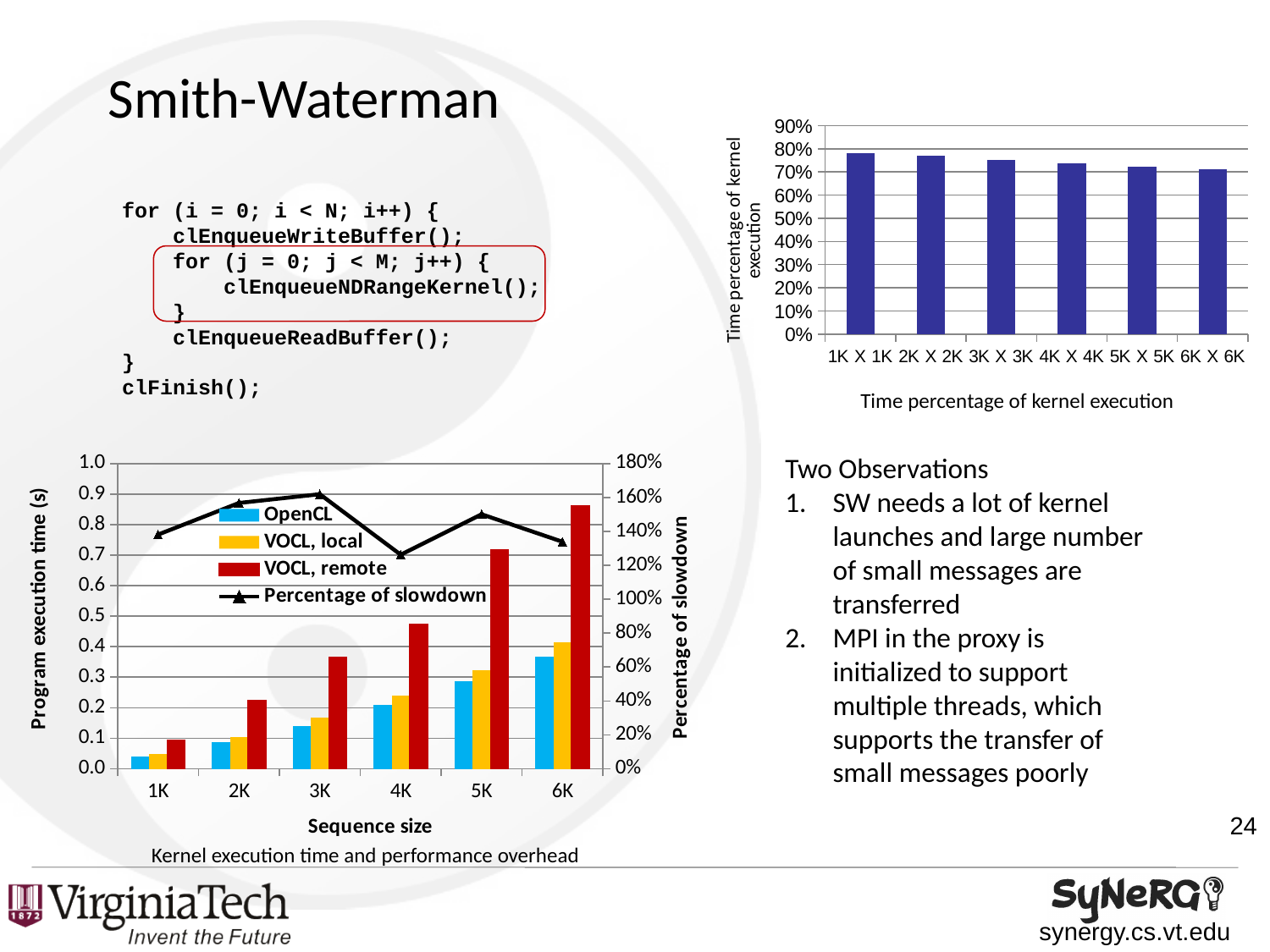
In the 'Kernel execution time and performance overhead' chart (bottom left), which series has the tallest bar at sequence size 6K? VOCL, remote In the 'Kernel execution time and performance overhead' chart (bottom left), what is the label of the left vertical axis? Program execution time (s) In the 'Time percentage of kernel execution' chart (top right), which category has the highest value? 1K X 1K In the 'Kernel execution time and performance overhead' chart (bottom left), do the OpenCL execution times rise or fall as sequence size increases? rise In the 'Kernel execution time and performance overhead' chart (bottom left), at which sequence size is the Percentage of slowdown lowest? 4K In the 'Kernel execution time and performance overhead' chart (bottom left), is the VOCL, remote execution time at 6K greater or less than 0.8 seconds? greater In the 'Kernel execution time and performance overhead' chart (bottom left), how many series does the legend list? 4 In the 'Time percentage of kernel execution' chart (top right), do the values rise or fall as the problem size increases along the x axis? fall In the 'Time percentage of kernel execution' chart (top right), how many categories are shown on the x axis? 6 In the 'Time percentage of kernel execution' chart (top right), which category has the lowest value? 6K X 6K In the 'Time percentage of kernel execution' chart (top right), is the value for 1K X 1K greater or less than 80%? less In the 'Kernel execution time and performance overhead' chart (bottom left), at which sequence size does the Percentage of slowdown line reach its highest point? 3K